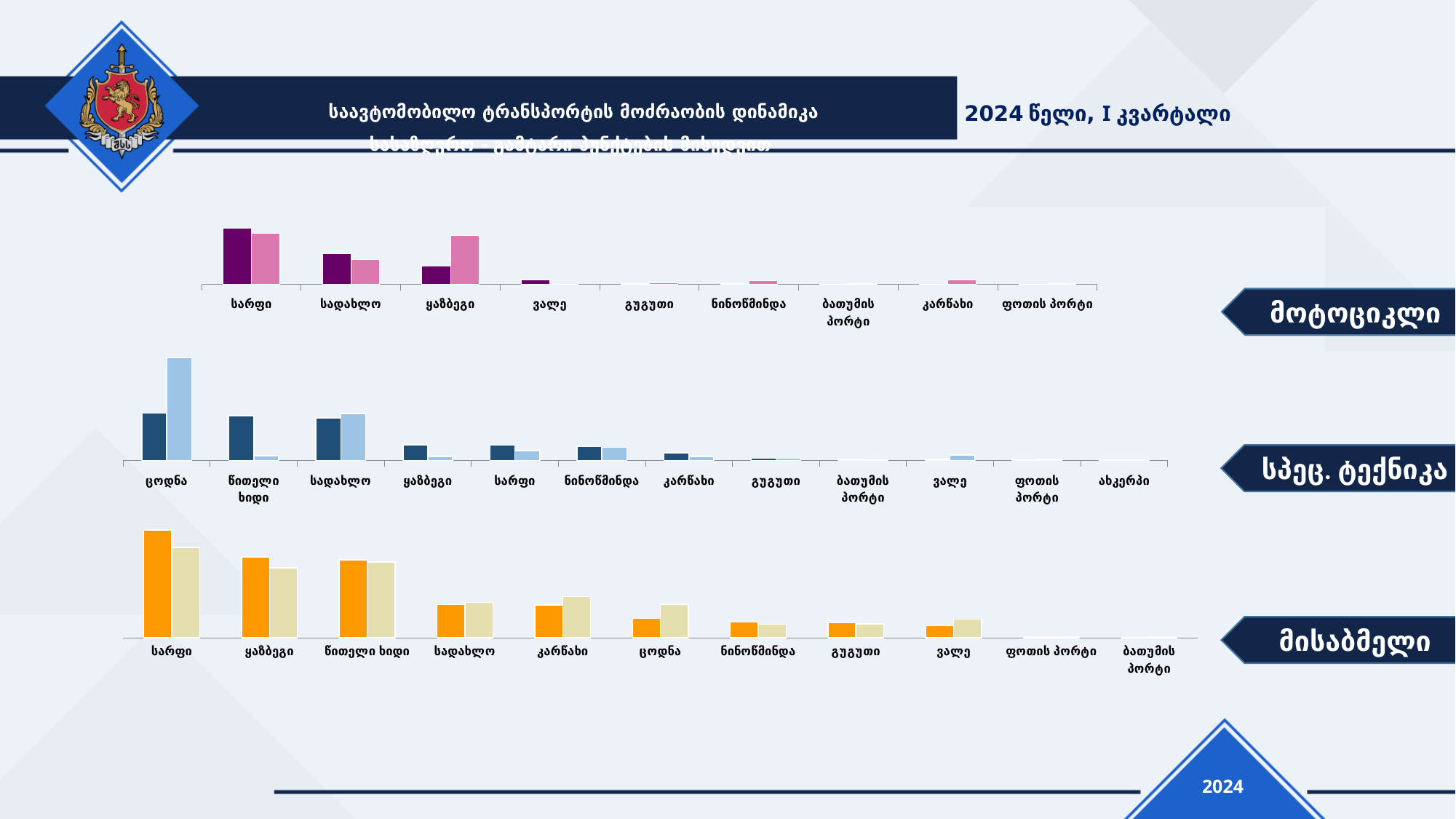
In the middle chart (სპეც. ტექნიკა), how many categories are shown on the x axis? 12 In the top chart (მოტოციკლი), which category has the tallest bar? სარფი What kind of chart is the top chart labelled მოტოციკლი? bar chart In the bottom chart (მისაბმელი), which category has the tallest bar? სარფი In the bottom chart (მისაბმელი), how many categories are shown on the x axis? 11 What period is stated in the header at the top right of the slide? 2024 წელი, I კვარტალი In the bottom chart (მისაბმელი), which has the taller orange bar, სარფი or ცოდნა? სარფი In the bottom chart (მისაბმელი), do the bar heights generally rise or fall from left to right along the x axis? fall In the top chart (მოტოციკლი), how many categories are shown on the x axis? 9 In the middle chart (სპეც. ტექნიკა), which category has the tallest bar? ცოდნა In the middle chart (სპეც. ტექნიკა), which has the taller light blue bar, ცოდნა or ვალე? ცოდნა